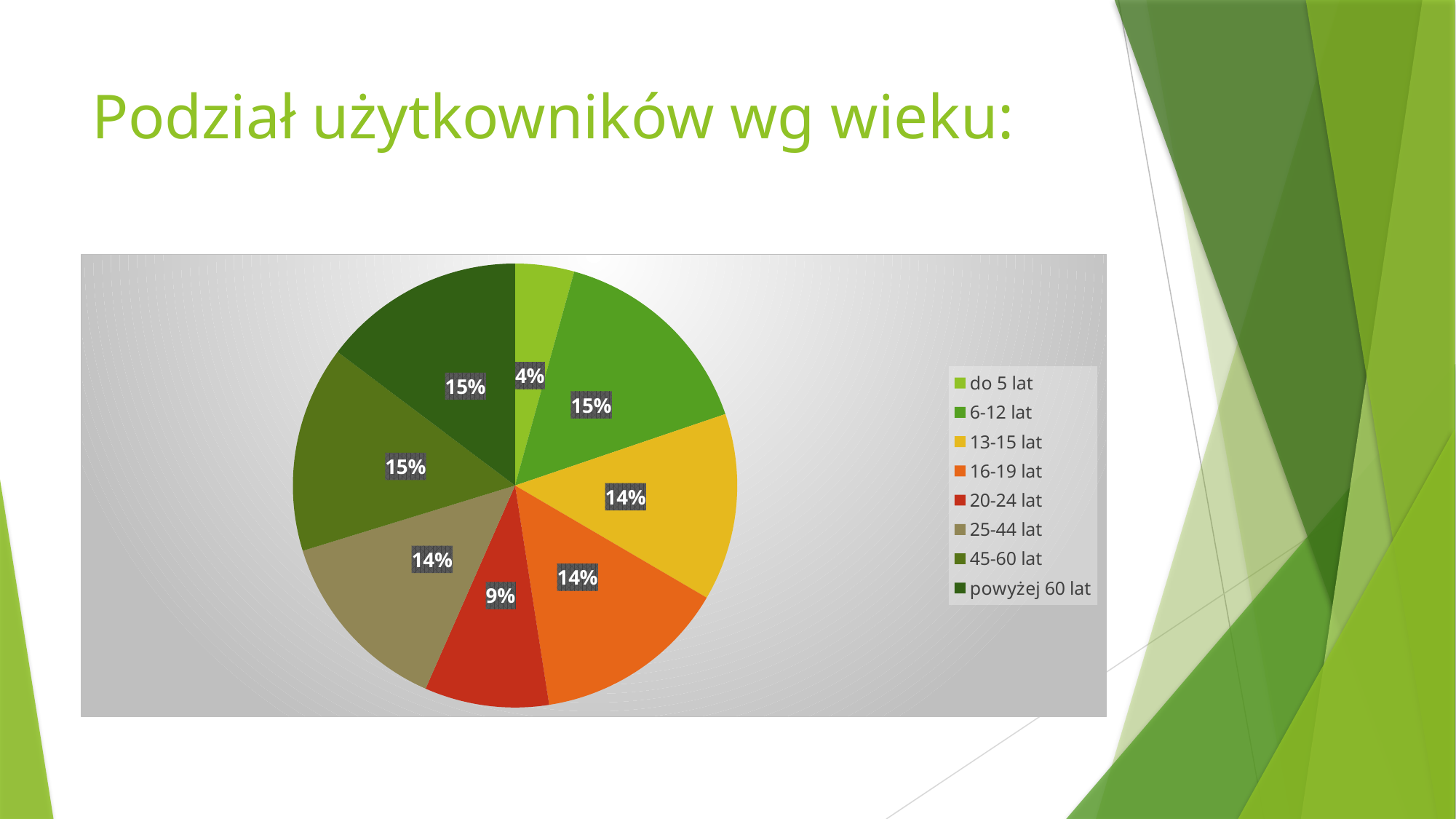
What share of users is in the 'powyżej 60 lat' age group? 15% What share of users is in the 'do 5 lat' age group? 4% What is the difference between the share for '6-12 lat' and the share for 'do 5 lat'? 11 percentage points What kind of chart is shown on the slide? pie chart What share of users is in the '20-24 lat' age group? 9% What is the difference between the share for '45-60 lat' and the share for '20-24 lat'? 6 percentage points What share of users is in the '6-12 lat' age group? 15% What is the title of the slide containing the pie chart? Podział użytkowników wg wieku: How many age groups does the pie chart show? 8 Which age group has the smallest share of users? do 5 lat Which has a larger share of users, '20-24 lat' or '25-44 lat'? 25-44 lat What share of users is in the '13-15 lat' age group? 14%